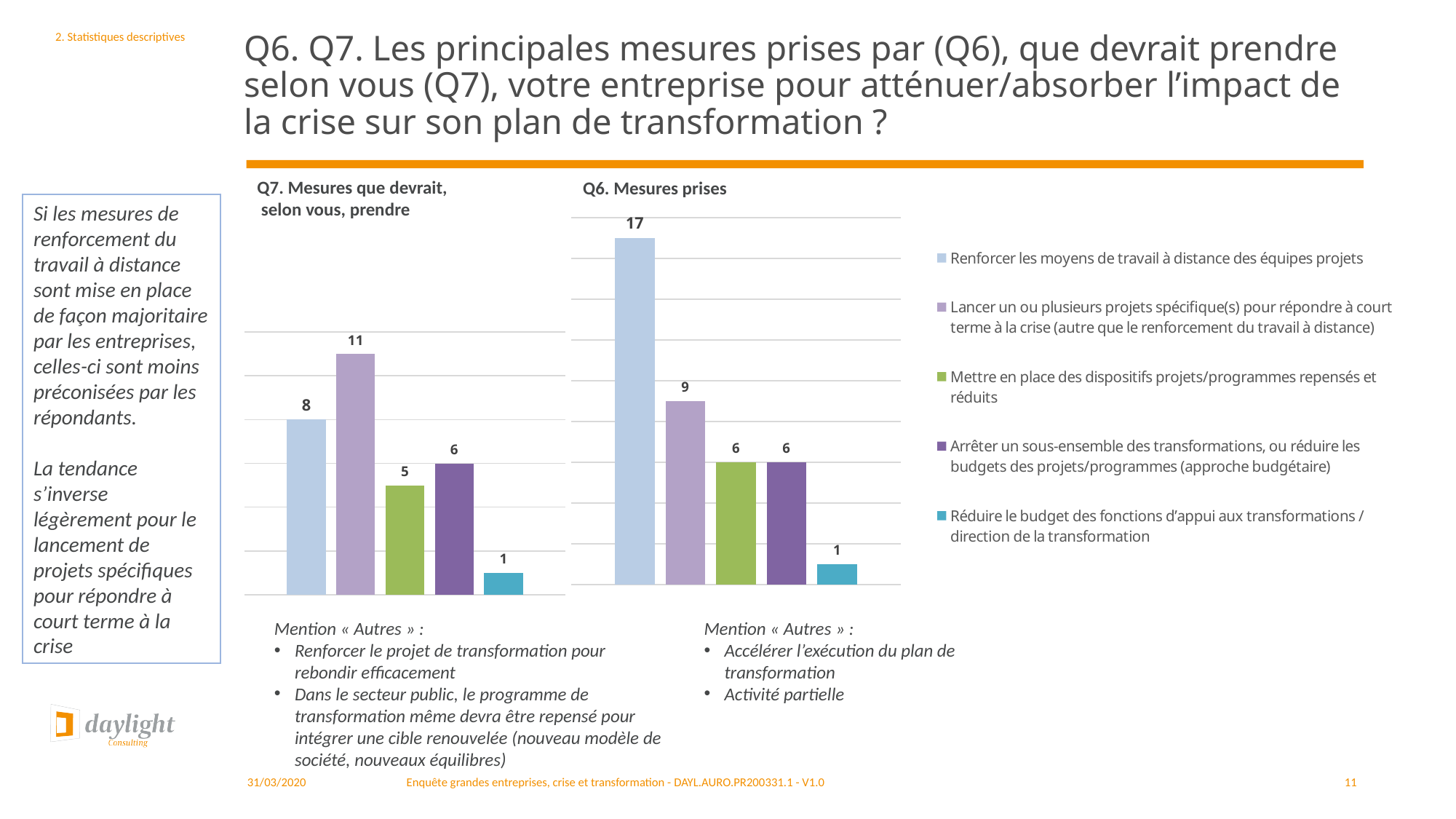
In the 'Q6. Mesures prises' chart, which measure has the lowest value? Réduire le budget des fonctions d'appui aux transformations / direction de la transformation In the 'Q7. Mesures que devrait, selon vous, prendre' chart, what is the value for 'Lancer un ou plusieurs projets spécifique(s) pour répondre à court terme à la crise'? 11 How many bars are shown in the 'Q6. Mesures prises' chart? 5 How many entries does the legend shared by the two charts list? 5 In the 'Q6. Mesures prises' chart, what is the difference between the value for 'Renforcer les moyens de travail à distance' and the value for 'Lancer un ou plusieurs projets spécifique(s)'? 8 Is the value for 'Renforcer les moyens de travail à distance des équipes projets' larger in the 'Q6. Mesures prises' chart or in the 'Q7. Mesures que devrait, selon vous, prendre' chart? Q6. Mesures prises In the 'Q6. Mesures prises' chart, what is the value for 'Renforcer les moyens de travail à distance des équipes projets'? 17 In the 'Q6. Mesures prises' chart, which measure has the highest value? Renforcer les moyens de travail à distance des équipes projets In the 'Q7. Mesures que devrait, selon vous, prendre' chart, which measure has the highest value? Lancer un ou plusieurs projets spécifique(s) pour répondre à court terme à la crise What type of chart is the 'Q7. Mesures que devrait, selon vous, prendre' chart? Bar chart In the 'Q7. Mesures que devrait, selon vous, prendre' chart, what is the value for 'Mettre en place des dispositifs projets/programmes repensés et réduits'? 5 In the 'Q7. Mesures que devrait, selon vous, prendre' chart, what is the difference between the value for 'Lancer un ou plusieurs projets spécifique(s)' and the value for 'Renforcer les moyens de travail à distance'? 3